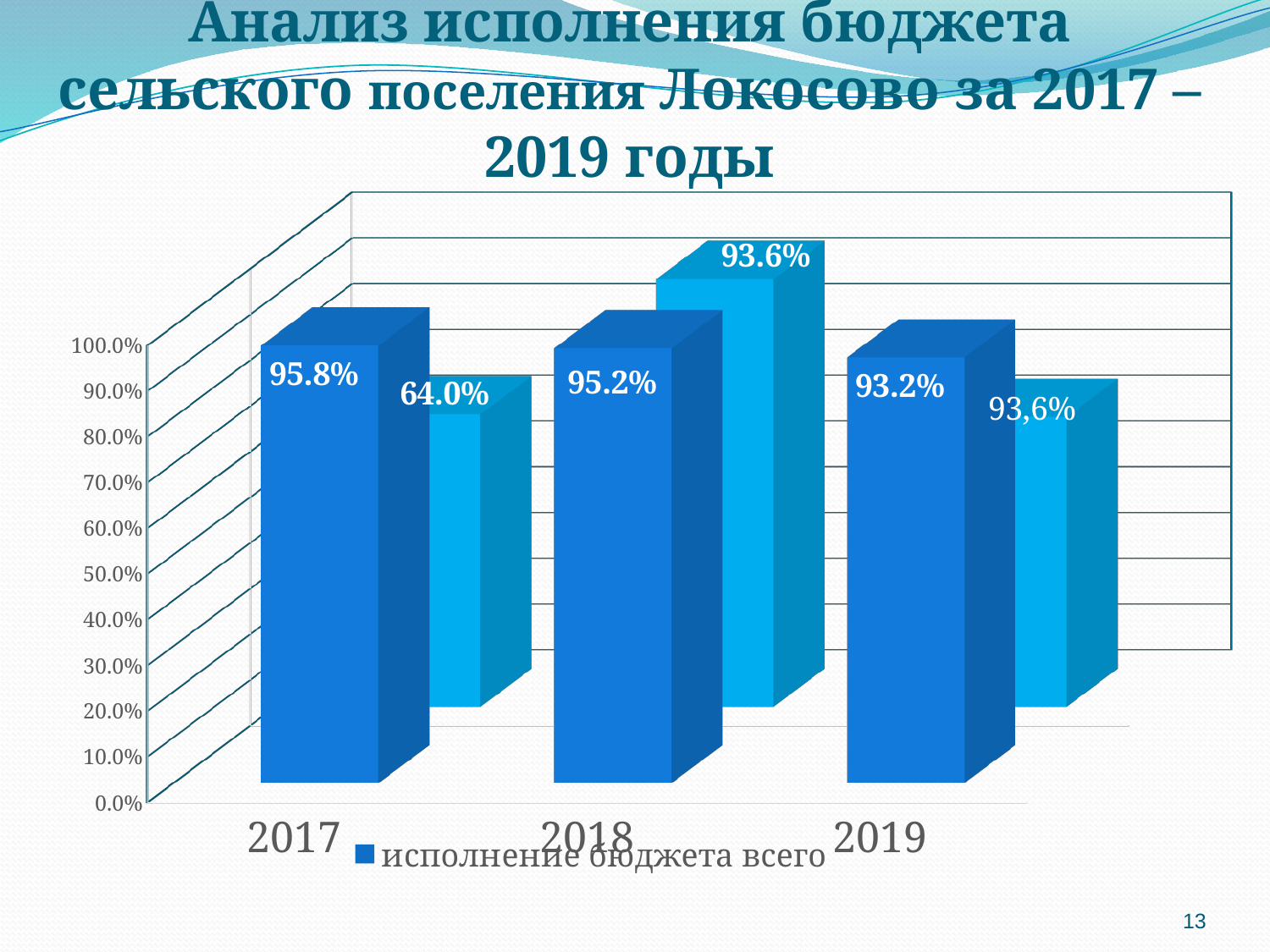
For 2017, which is larger: the "исполнение бюджета всего" bar or the lighter blue bar? исполнение бюджета всего How many years are shown on the x axis? 3 What is the value of "исполнение бюджета всего" for 2017? 95.8% By how many percentage points does "исполнение бюджета всего" in 2017 exceed that in 2019? 2.6 percentage points In which year is "исполнение бюджета всего" lowest? 2019 In which year is "исполнение бюджета всего" highest? 2017 What kind of chart is shown on the slide? bar chart What value is printed on the lighter blue bar for 2018? 93.6% What is the value of "исполнение бюджета всего" for 2018? 95.2% What is the value of "исполнение бюджета всего" for 2019? 93.2% What value is printed on the lighter blue bar for 2017? 64.0% Does "исполнение бюджета всего" rise or fall from 2017 to 2019? fall